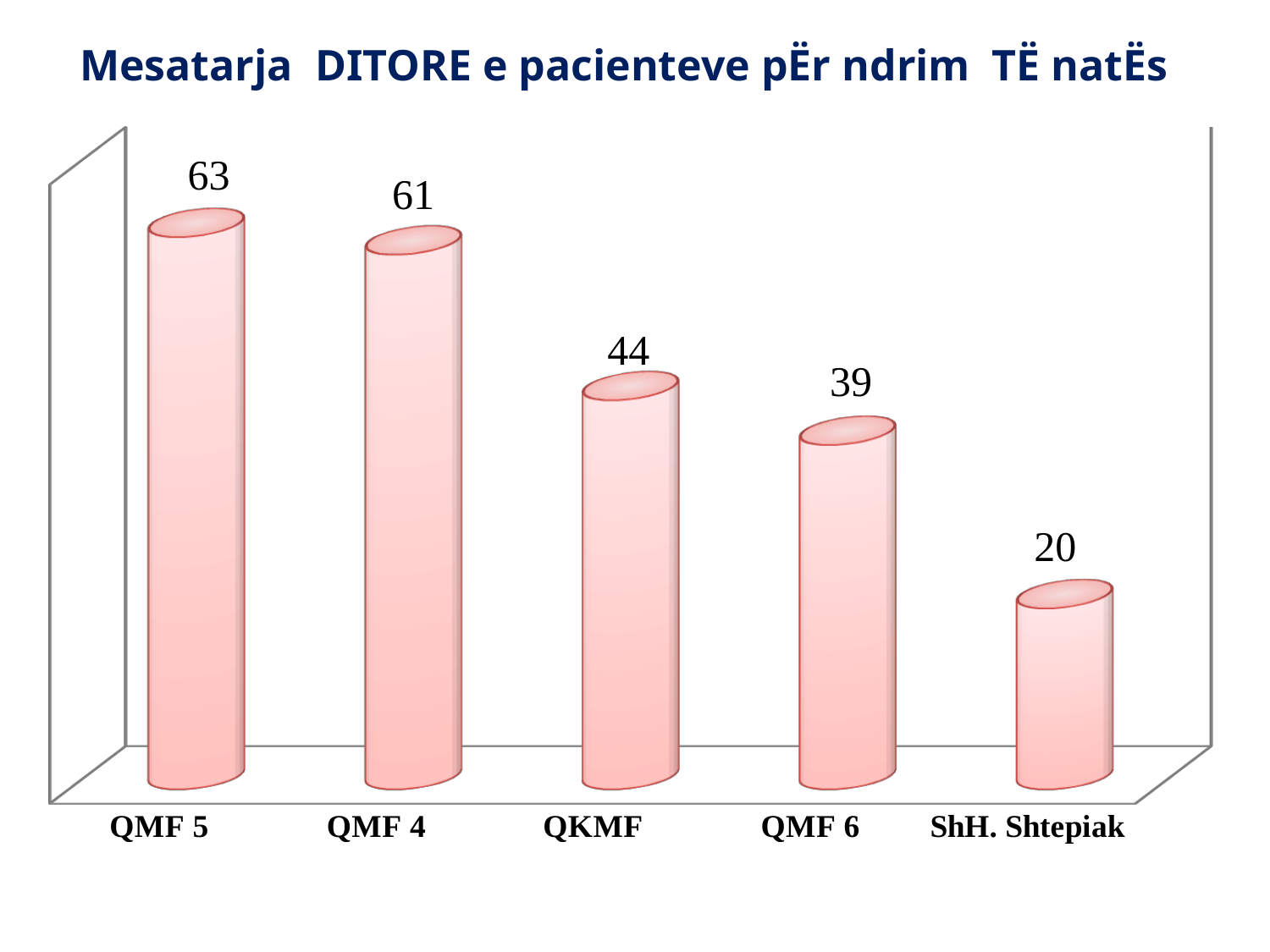
Which category has the highest value? QMF 5 What is the difference between the values for QMF 4 and QMF 6? 22 What is the difference between the values for QMF 5 and ShH. Shtepiak? 43 What kind of chart is shown on the slide? bar chart What is the value for QKMF? 44 What is the value for ShH. Shtepiak? 20 How many categories are shown on the chart? 5 What is the value for QMF 6? 39 Which is larger, the value for QKMF or the value for QMF 6? QKMF Do the values rise or fall from left to right along the x axis? fall What is the value for QMF 5? 63 Which category has the lowest value? ShH. Shtepiak